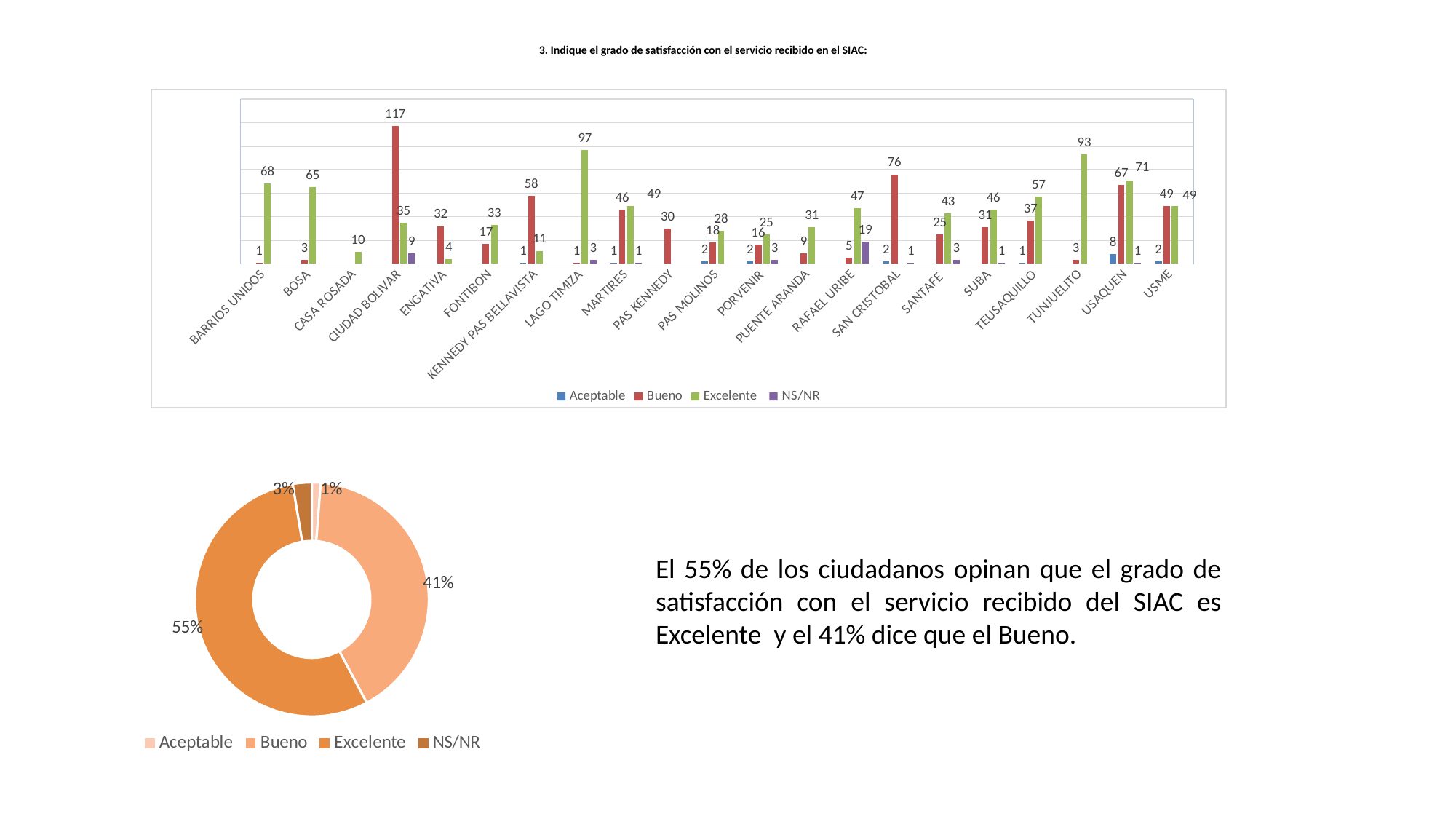
In the bar chart, what is the Excelente value for LAGO TIMIZA? 97 In the bar chart, what is the Excelente value for TUNJUELITO? 93 How many categories are shown on the x axis of the bar chart? 21 In the bar chart, which category has the highest Bueno value? CIUDAD BOLIVAR What kind of chart is the chart at the top of the slide? Bar chart In the bar chart, which is larger: the Excelente value for TUNJUELITO or the Bueno value for SAN CRISTOBAL? Excelente value for TUNJUELITO In the bar chart, what is the Bueno value for CIUDAD BOLIVAR? 117 In the bar chart, which category has the highest Excelente value? LAGO TIMIZA How many series does the legend of the bar chart list? 4 In the bar chart, what is the difference between the Bueno and Excelente values for CIUDAD BOLIVAR? 82 In the doughnut chart at the bottom left, what share does Excelente have? 55% In the doughnut chart at the bottom left, which category has the smallest share? Aceptable